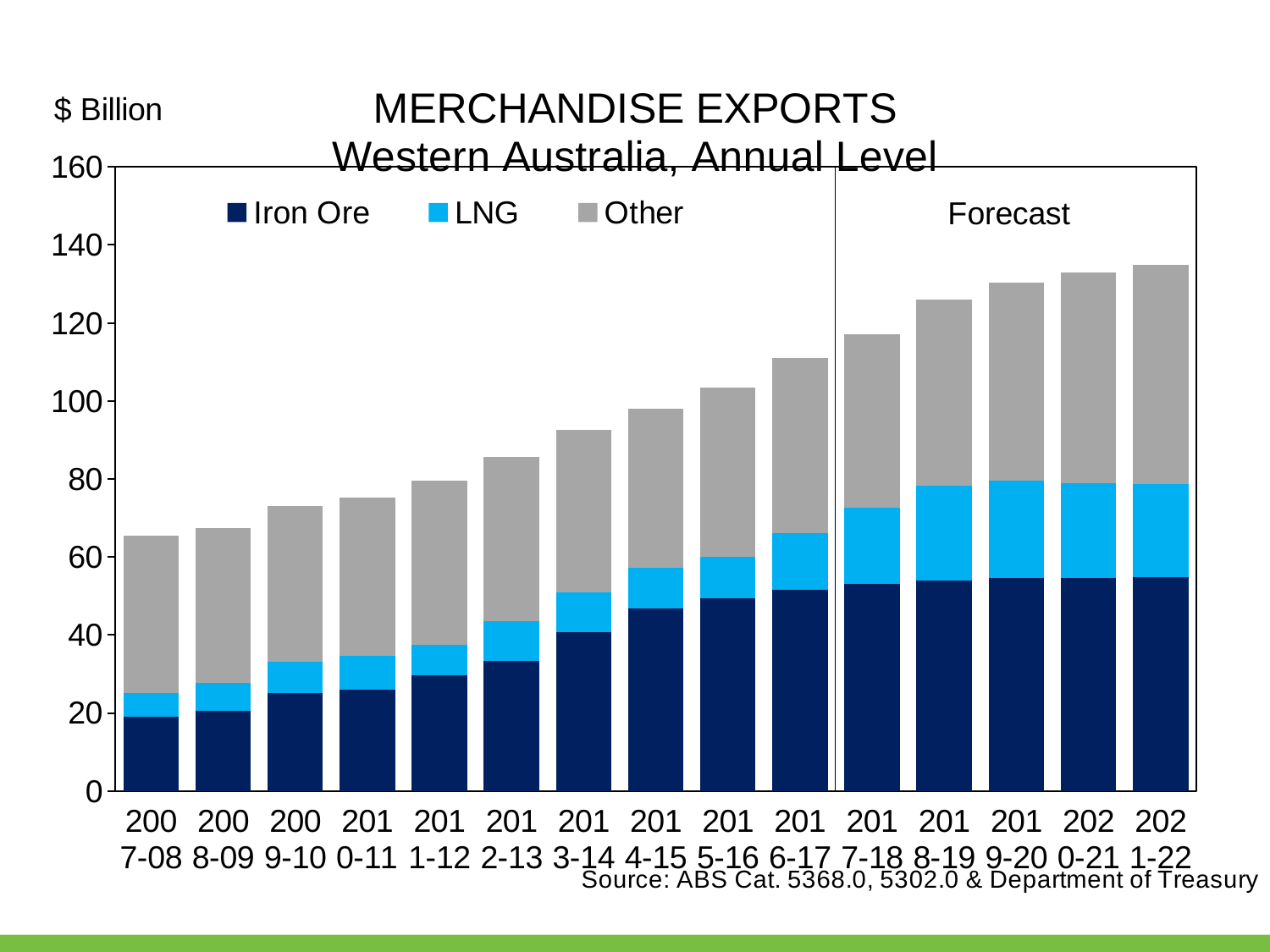
Which year has the larger total merchandise exports, 2007-08 or 2016-17? 2016-17 What unit is shown for the y axis of the chart? $ Billion Is the total value for 2007-08 greater or less than 60? greater How many series does the legend list? 3 Which year has the highest total merchandise exports? 2021-22 What kind of chart is shown on the slide? Stacked bar chart Is the total value for 2021-22 greater or less than 120? greater Do total merchandise exports rise or fall from 2007-08 to 2021-22? Rise How many financial years are plotted along the x axis? 15 Is the total value for 2013-14 greater or less than 100? less Which year has the lowest total merchandise exports? 2007-08